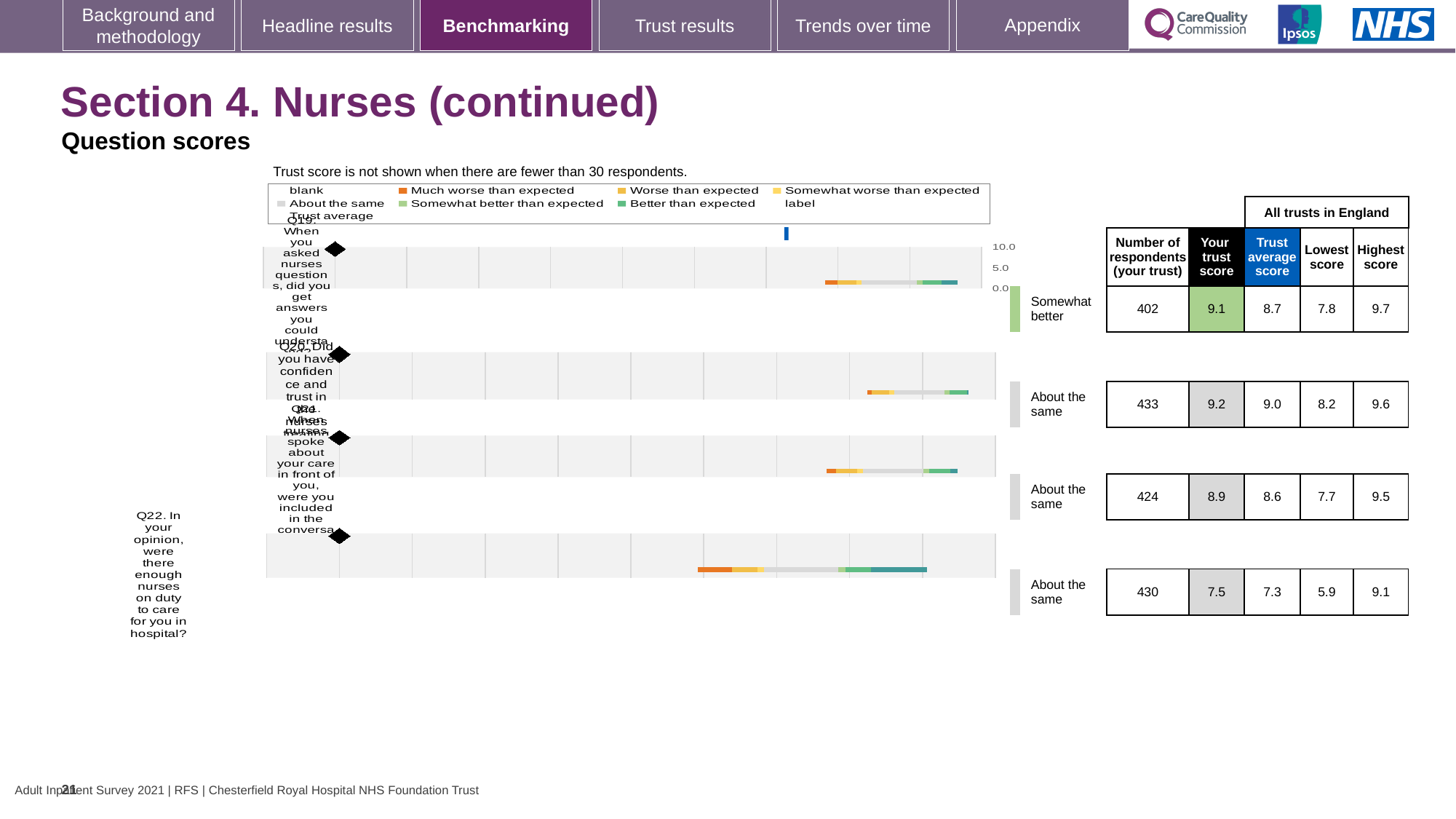
Which question has the highest trust score on this slide? Q20 What is the difference between the trust score and the trust average score for Q22? 0.2 What is the highest score across all trusts in England for Q21 (were you included in the conversation when nurses spoke about your care)? 9.5 What is the trust average score for Q19 (did you get answers you could understand when you asked nurses questions)? 8.7 Which is larger for Q19: the trust score or the trust average score? Trust score How many questions are plotted on the chart? 4 What kind of chart is shown on the slide? Bar chart What benchmark category is shown for Q19? Somewhat better Which question has the lowest trust score on this slide? Q22 What is the lowest score across all trusts in England for Q22? 5.9 What is the trust score for Q22 (enough nurses on duty to care for you in hospital)? 7.5 How many respondents answered Q20 (confidence and trust in the nurses) at this trust? 433